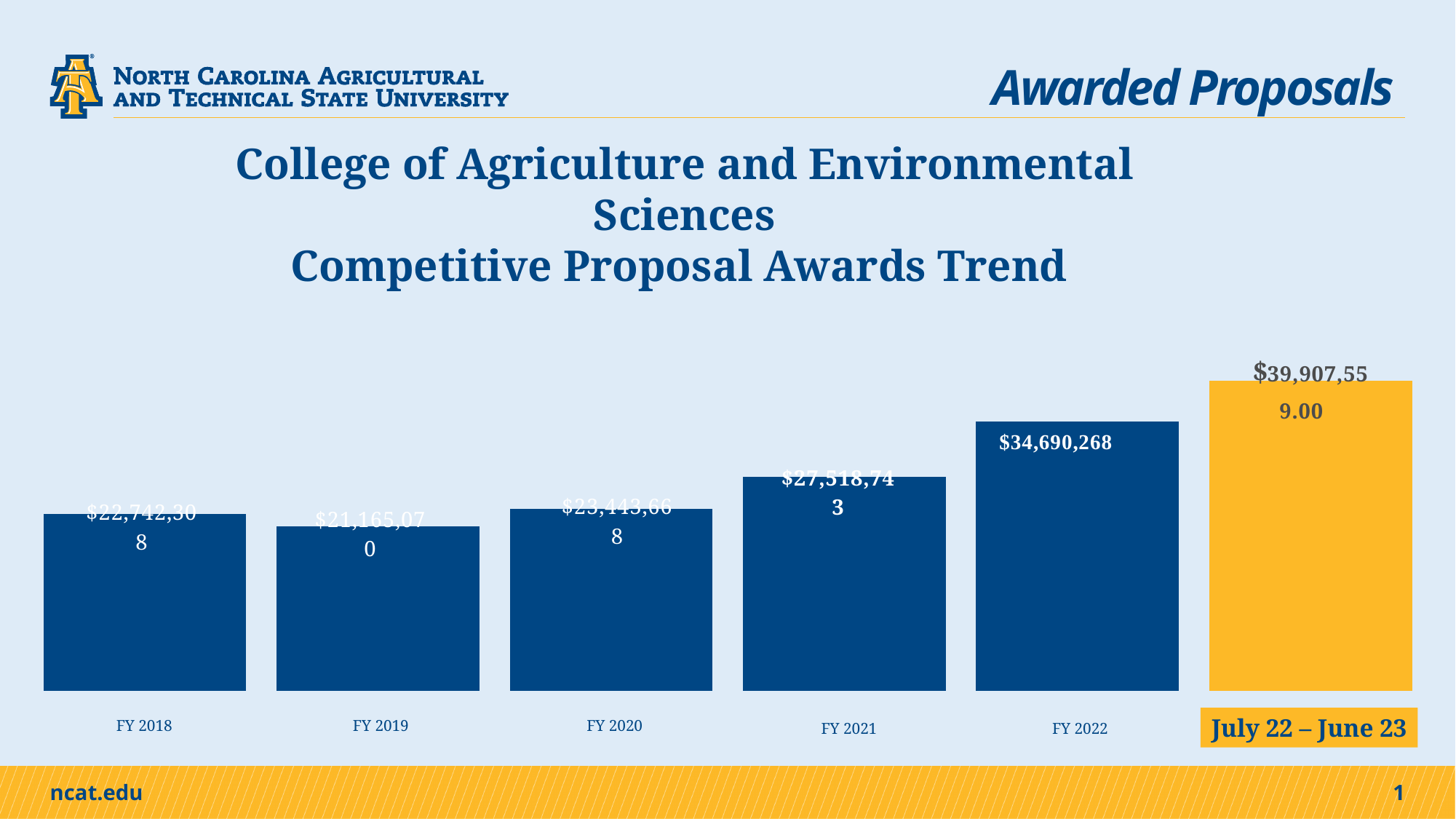
Which bar is shown in a different colour (gold) from the others? July 22 – June 23 Which is larger, the awarded amount for FY 2018 or FY 2020? FY 2020 What is the awarded amount for FY 2022? $34,690,268 What type of chart is shown on the slide? Bar chart What is the difference between the awarded amounts for FY 2020 and FY 2019? $2,278,598 What is the awarded amount for FY 2021? $27,518,743 Which period has the lowest awarded amount? FY 2019 How many periods are shown in the chart? 6 Which period has the highest awarded amount? July 22 – June 23 What is the difference between the awarded amounts for FY 2022 and FY 2021? $7,171,525 What is the awarded amount for FY 2019? $21,165,070 What is the awarded amount for July 22 – June 23? $39,907,559.00